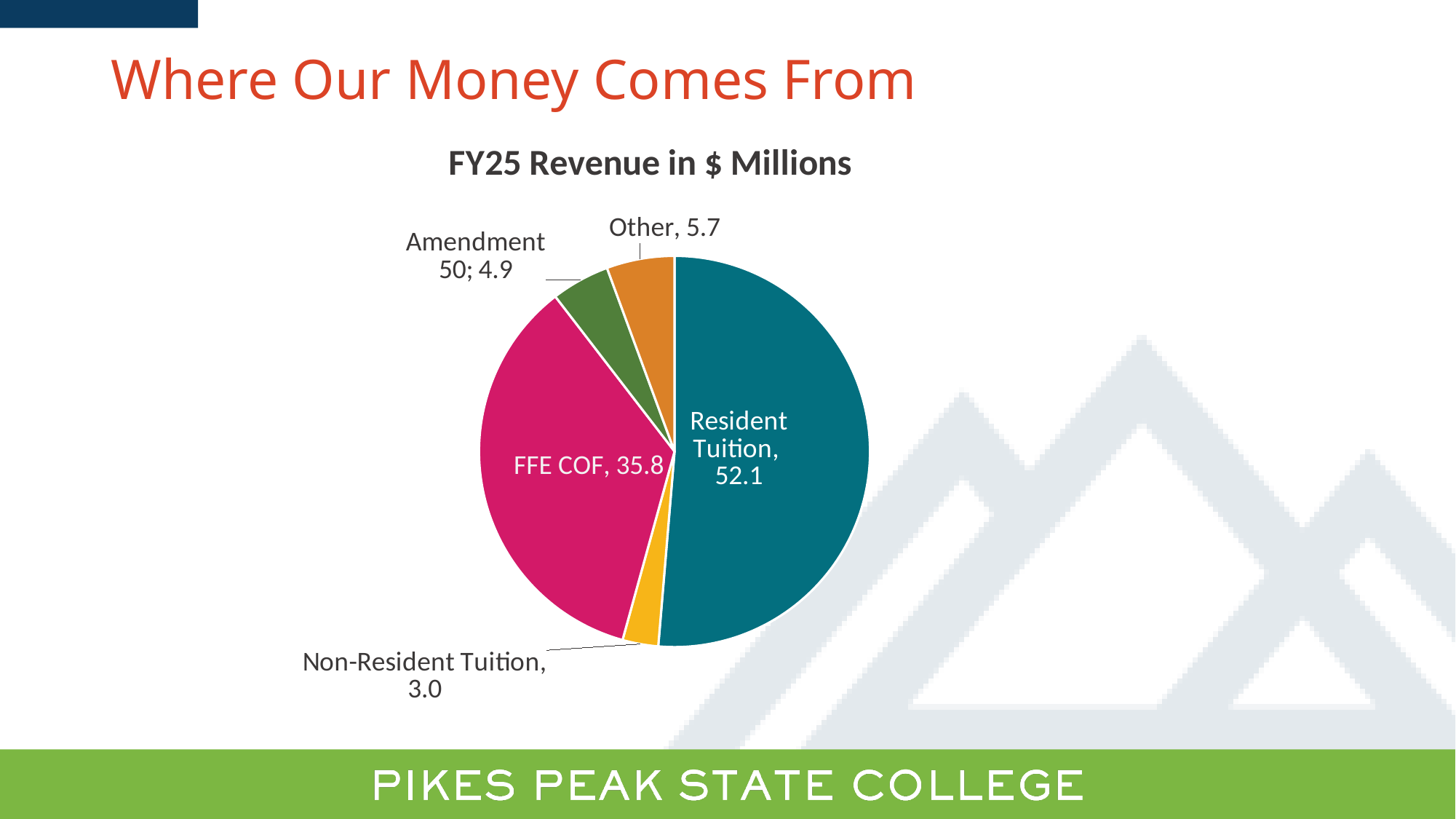
Which is larger in the pie chart, Other or Amendment 50? Other What is the value for Amendment 50 in the pie chart? 4.9 What is the value for Resident Tuition in the FY25 Revenue pie chart? 52.1 Which revenue source has the largest slice in the pie chart? Resident Tuition How many slices does the pie chart have? 5 What type of chart is shown on the slide? Pie chart What is the value for Non-Resident Tuition in the pie chart? 3.0 Which revenue source has the smallest slice in the pie chart? Non-Resident Tuition What is the title of the chart on the slide? FY25 Revenue in $ Millions What is the difference between Resident Tuition and FFE COF in the pie chart? 16.3 What is the value for FFE COF in the pie chart? 35.8 What is the difference between Other and Amendment 50 in the pie chart? 0.8